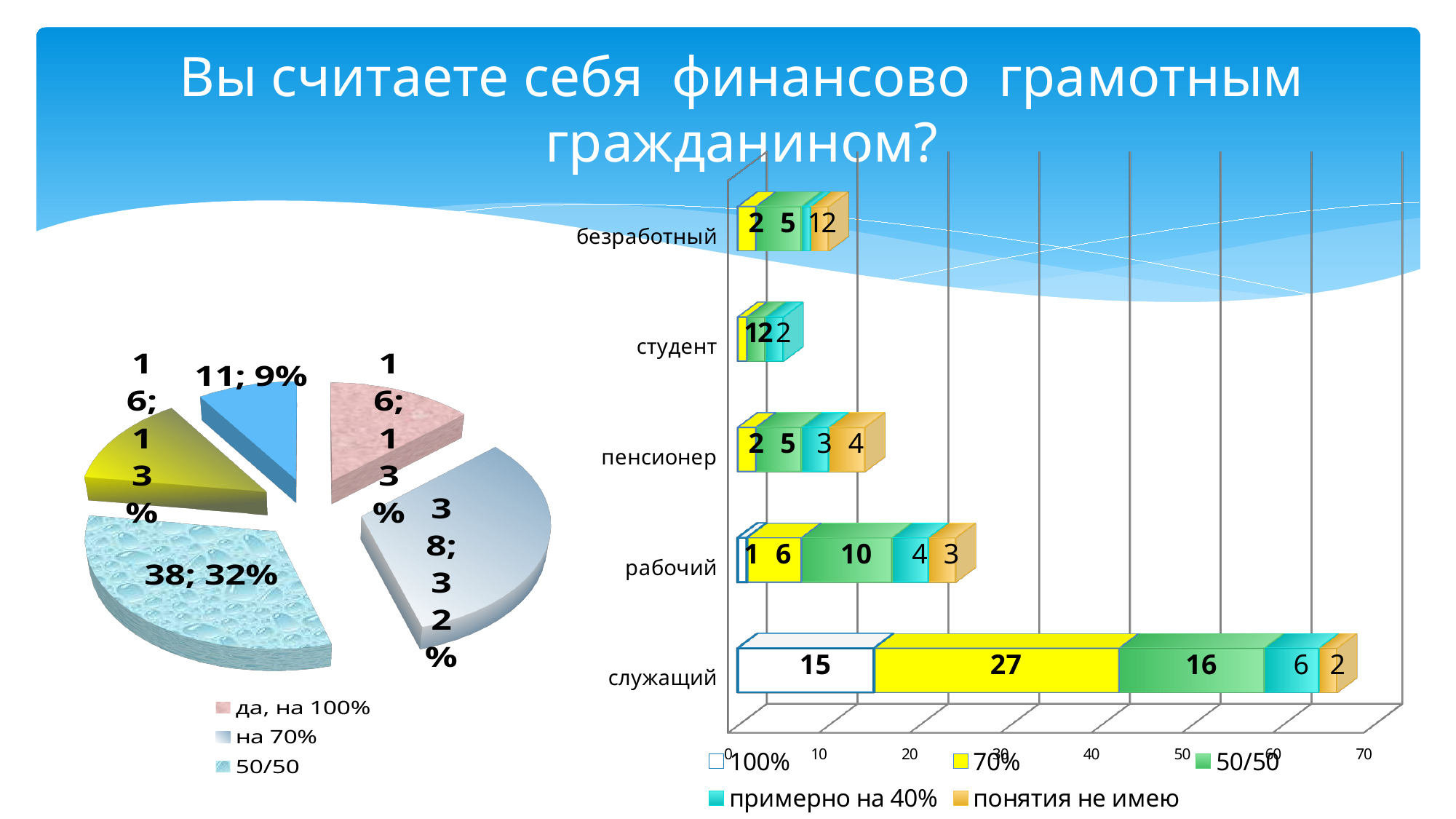
In the bar chart on the right, what is the total of the stacked bar for рабочий? 24 In the bar chart on the right, what is the value of the 50/50 series for рабочий? 10 In the bar chart on the right, what is the value of the 100% series for служащий? 15 In the bar chart on the right, what is the value of the понятия не имею series for пенсионер? 4 In the bar chart on the right, what is the total of the stacked bar for служащий? 66 In the pie chart on the left, what share does the 50/50 slice represent? 32% In the bar chart on the right, what is the difference between the 70% value and the 50/50 value for служащий? 11 In the bar chart on the right, how many series does the legend list? 5 In the bar chart on the right, how many categories are shown on the vertical axis? 5 In the bar chart on the right, which category has the longest stacked bar? служащий In the pie chart on the left, what value is shown for the да, на 100% slice? 16 In the bar chart on the right, what is the value of the 70% series for служащий? 27